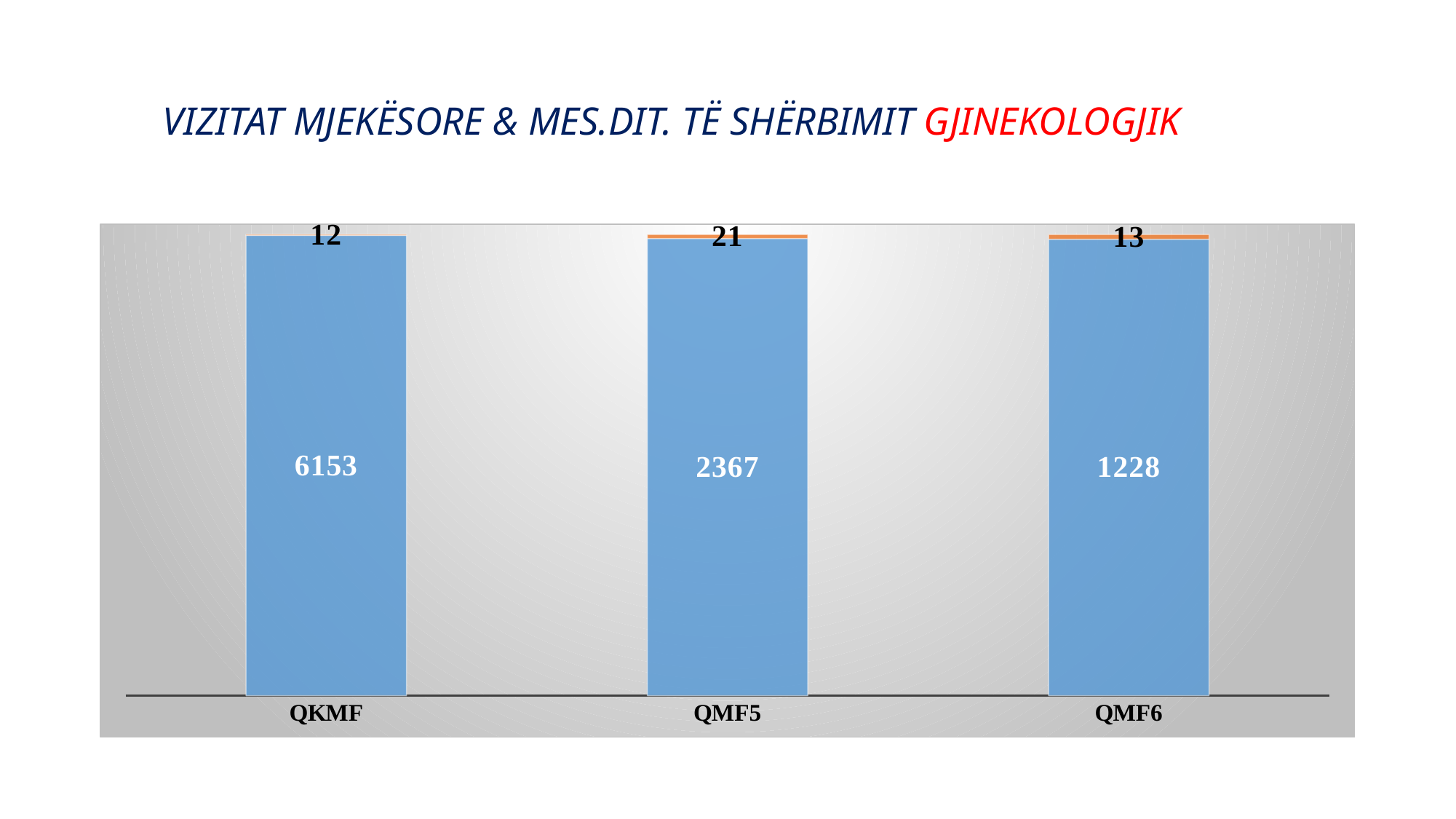
Which category has the lowest value for the blue segment? QMF6 What is the total of the two labelled segments in the QMF6 bar? 1241 Which has a larger orange segment value, QMF5 or QMF6? QMF5 How many categories are shown on the x axis? 3 What is the value of the orange segment for QKMF? 12 What is the value of the blue segment for QKMF? 6153 What is the value of the blue segment for QMF5? 2367 What is the value of the orange segment for QMF5? 21 What kind of chart is shown on the slide? Stacked bar chart What is the value of the blue segment for QMF6? 1228 What is the difference between the blue segment values for QKMF and QMF5? 3786 Which category has the highest value for the blue segment? QKMF